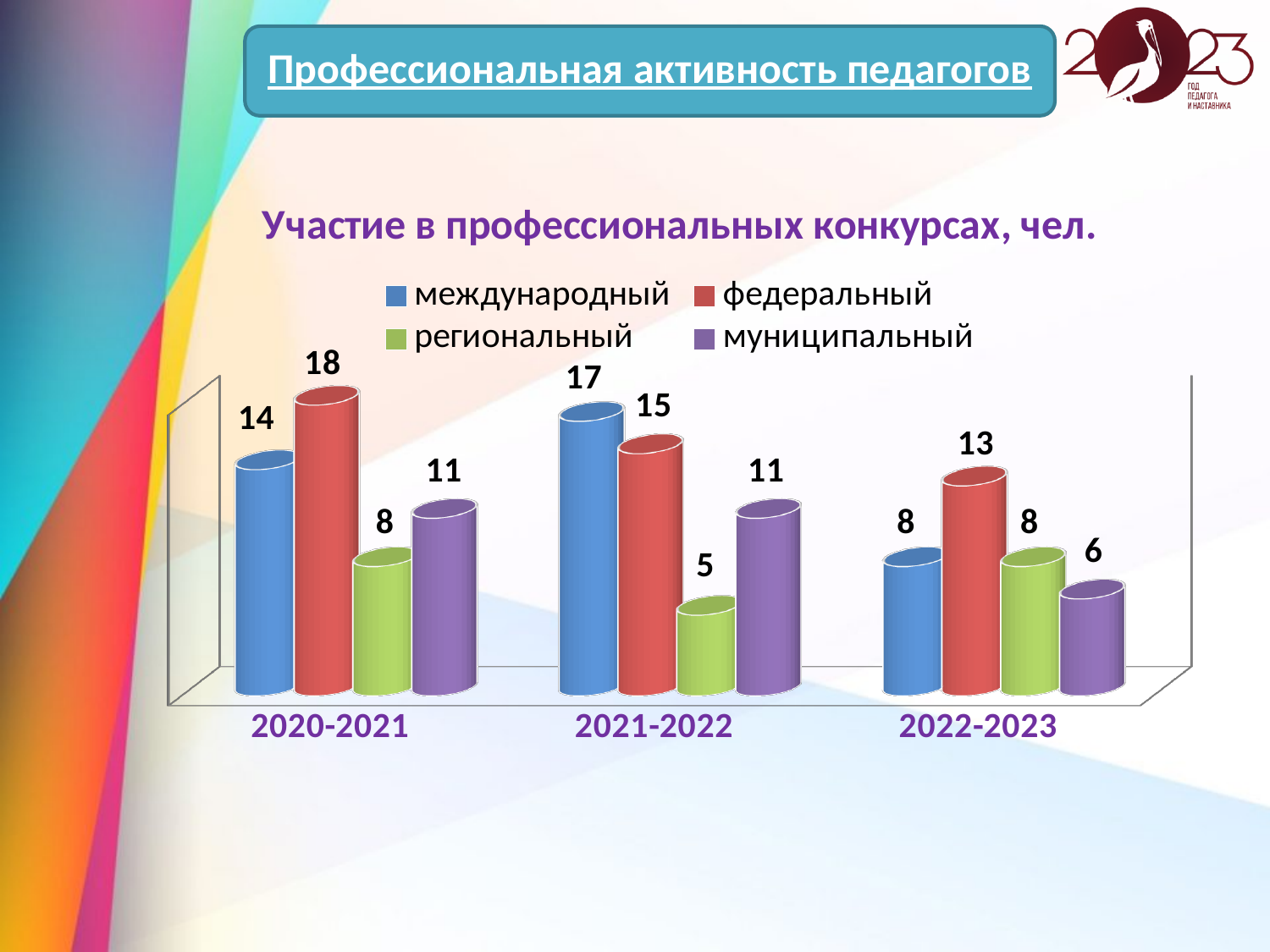
Which is larger in 2021-2022: международный or федеральный? международный Which series has the lowest value in 2021-2022? региональный What is the value for международный in 2020-2021? 14 How many series does the legend list? 4 What is the value for региональный in 2021-2022? 5 What kind of chart is shown? bar chart What is the difference between федеральный and международный in 2020-2021? 4 Which series has the highest value in 2020-2021? федеральный How many periods are shown on the x axis? 3 Does the value for федеральный rise or fall from 2021-2022 to 2022-2023? fall What is the value for федеральный in 2021-2022? 15 What is the value for муниципальный in 2022-2023? 6